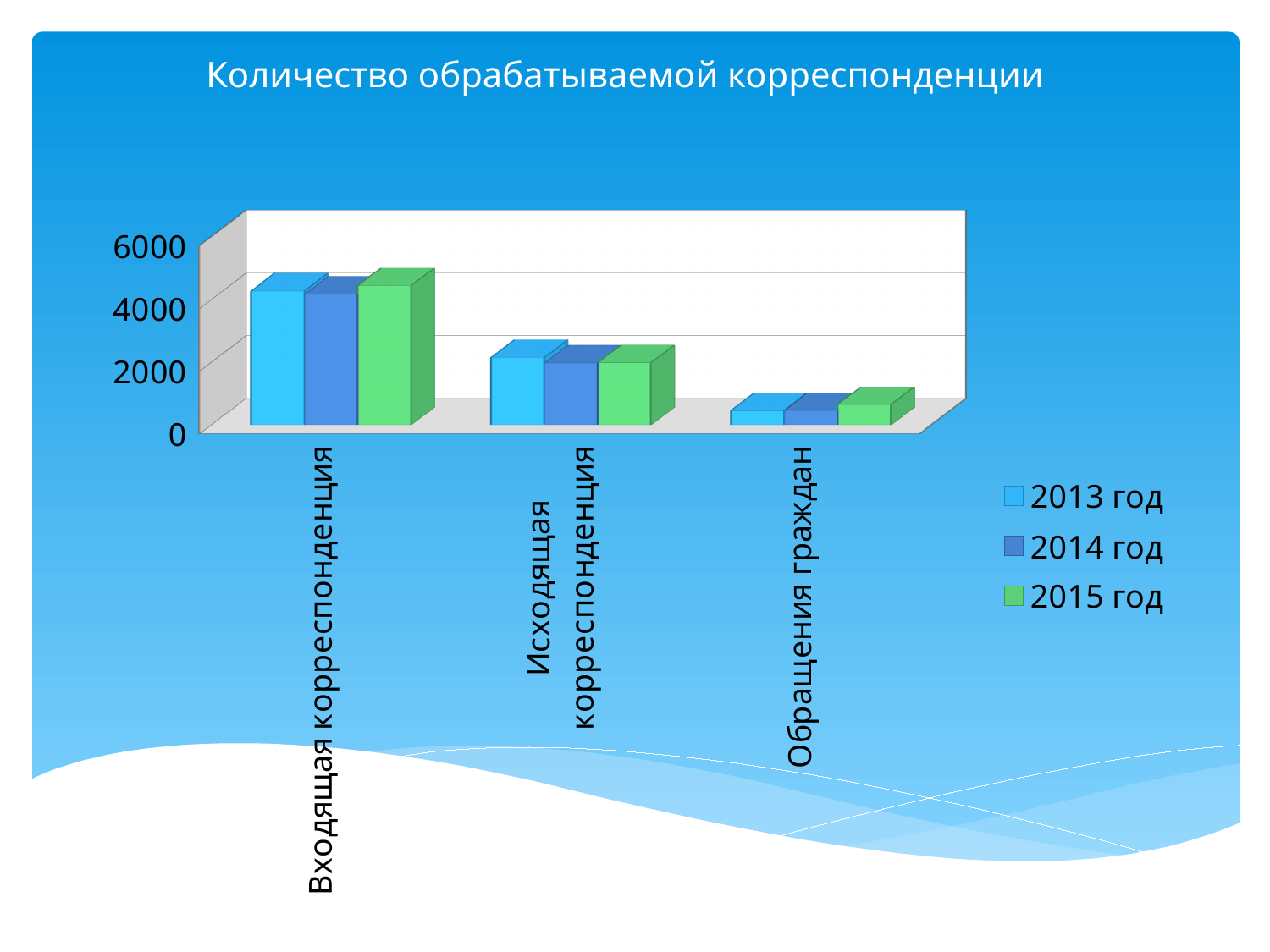
What kind of chart is shown on the slide? bar chart Which category has the lowest values across all years? Обращения граждан How many series does the legend list? 3 Which category has the highest values across all years? Входящая корреспонденция What is the title of the chart? Количество обрабатываемой корреспонденции How many categories are shown on the x axis? 3 Is the value for Обращения граждан in 2015 год greater or less than 2000? less Which years are listed in the legend? 2013 год, 2014 год, 2015 год Is the value for Входящая корреспонденция in 2015 год greater or less than 6000? less Is the value for Исходящая корреспонденция in 2014 год greater or less than 4000? less For 2015 год, which is larger: Входящая корреспонденция or Исходящая корреспонденция? Входящая корреспонденция